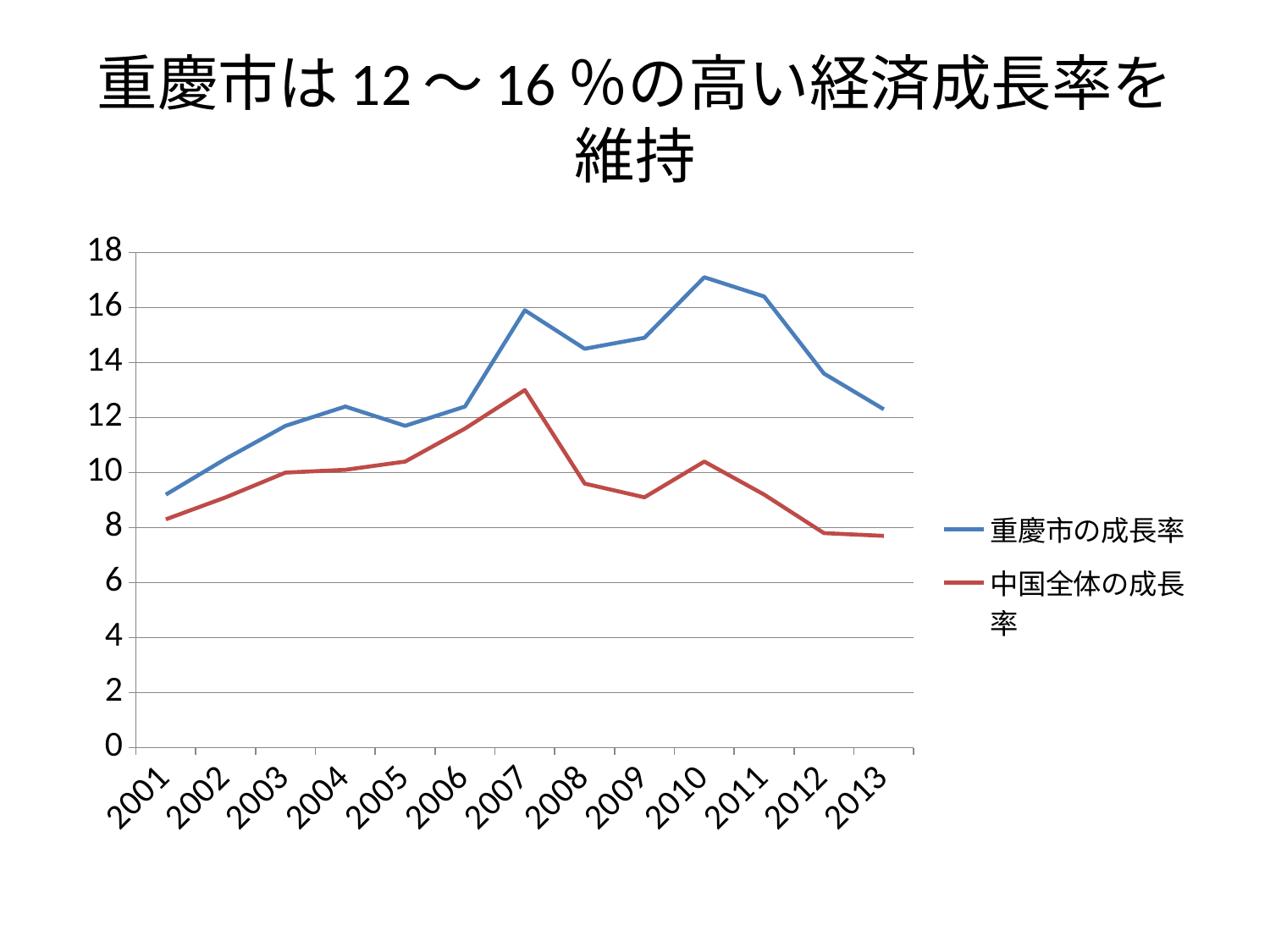
Is the value for 重慶市の成長率 in 2010 greater or less than 16? greater Is the value for 重慶市の成長率 in 2001 greater or less than 10? less In which year is 中国全体の成長率 highest? 2007 How many years are plotted along the x axis? 13 In 2007, which series has the larger value, 重慶市の成長率 or 中国全体の成長率? 重慶市の成長率 What kind of chart is shown on the slide? line chart Is the value for 中国全体の成長率 in 2007 greater or less than 12? greater Does 中国全体の成長率 rise or fall from 2010 to 2013? fall In which year is 重慶市の成長率 highest? 2010 How many series does the legend list? 2 In which year is 重慶市の成長率 lowest? 2001